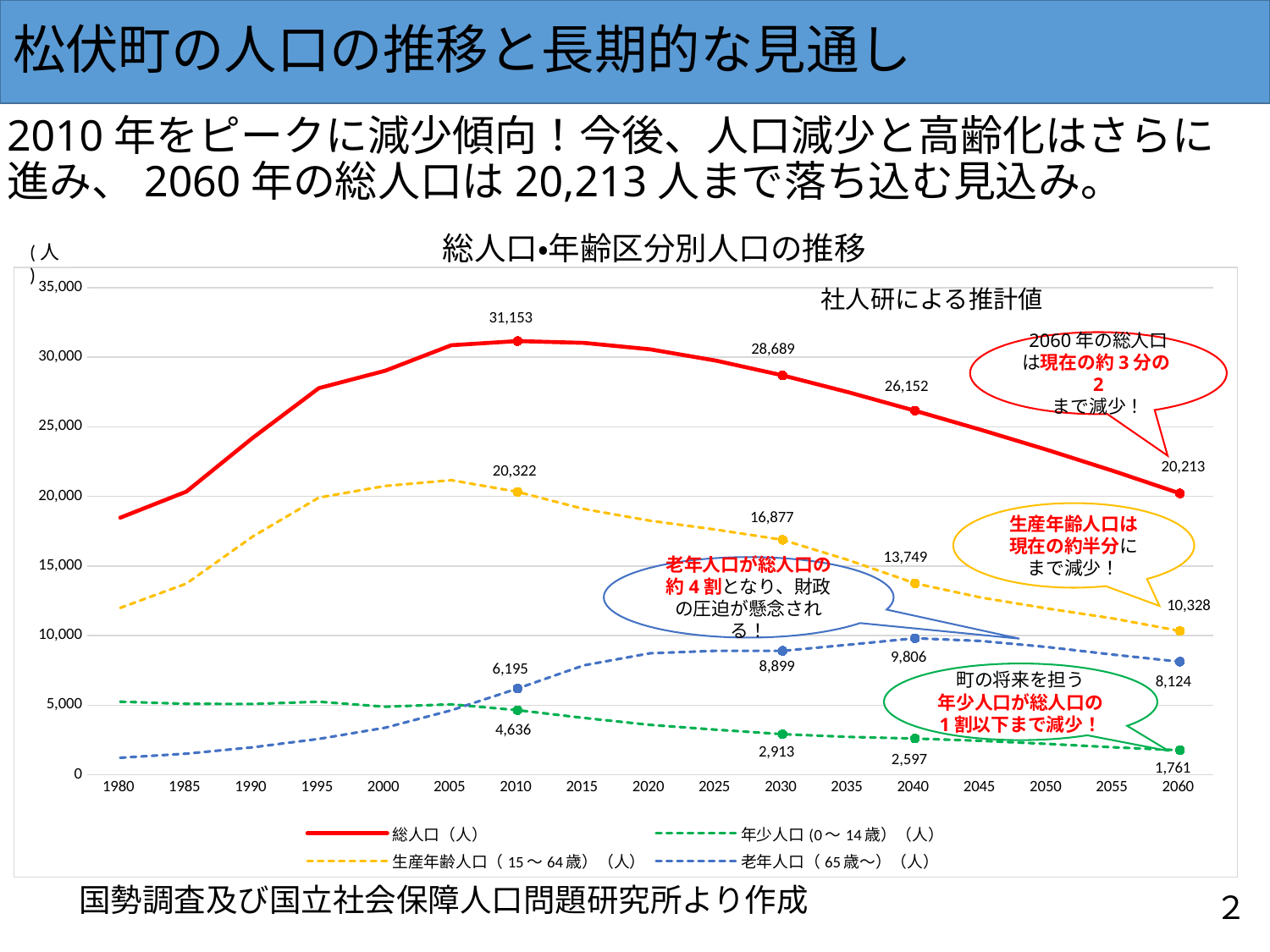
What is the difference between 総人口 in 2010 and 総人口 in 2060? 10,940 Which is larger in 2040: 老年人口 or 年少人口? 老年人口 What is the value of 生産年齢人口 in 2040? 13,749 Does 生産年齢人口 rise or fall from 2010 to 2060? fall What is the value of 老年人口 in 2030? 8,899 What is the value of 総人口 in 2010? 31,153 How many series does the legend list? 4 What is the value of 年少人口 in 2060? 1,761 What is the value of 総人口 in 2060? 20,213 What type of chart is shown on the slide? line chart Is the value of 総人口 in 1980 greater or less than 15,000? greater What is the title of the chart? 総人口・年齢区分別人口の推移